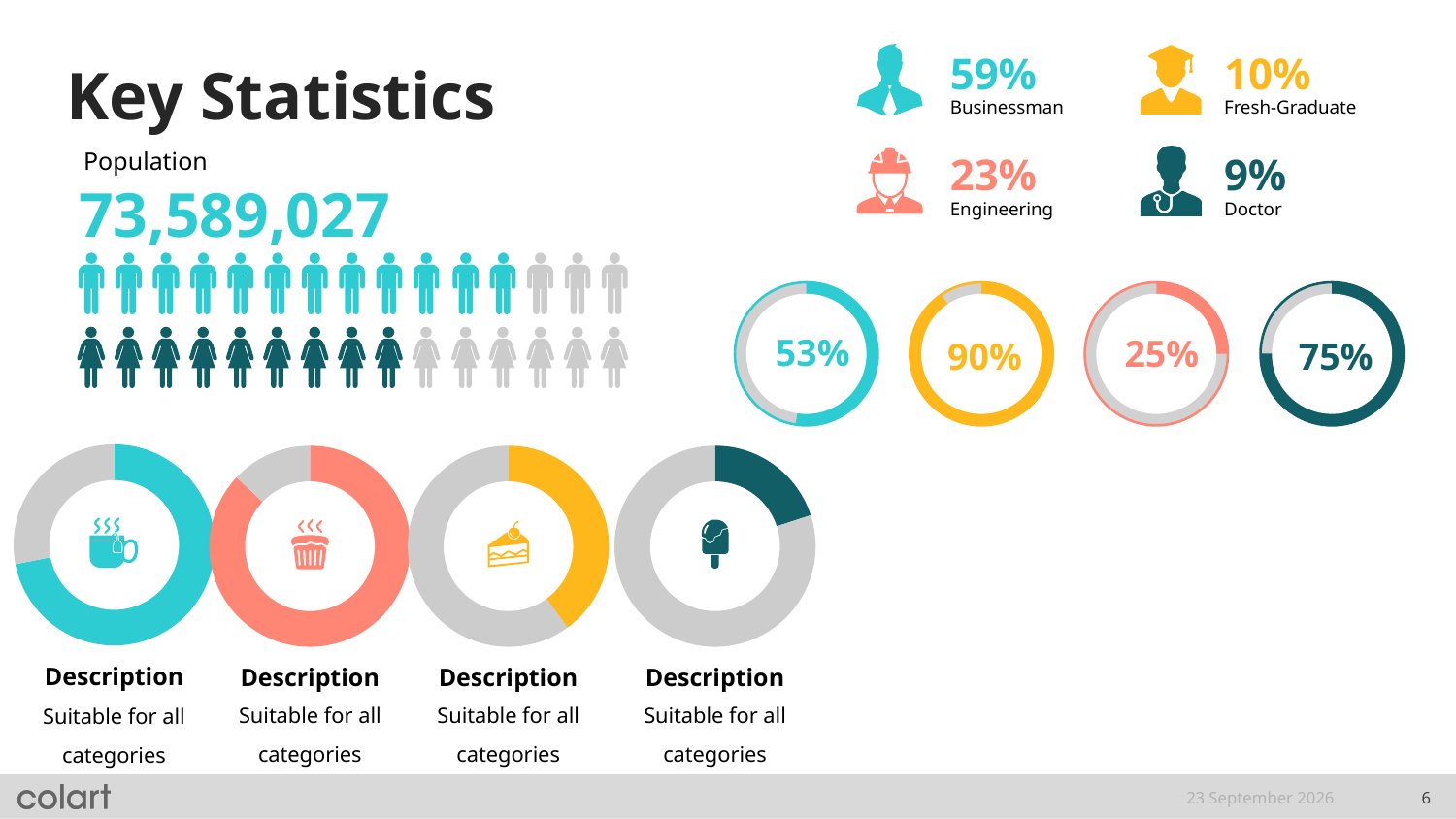
What is the difference between the Businessman percentage and the Engineering percentage in the icon statistics? 36% What percentage is shown for Businessman in the icon statistics at the top right? 59% What percentage is shown for Engineering in the icon statistics? 23% Of the four ring charts on the right (53%, 90%, 25%, 75%), which value is the highest? 90% What population figure is printed under the 'Population' label? 73,589,027 Which is larger in the icon statistics, the Fresh-Graduate percentage or the Doctor percentage? Fresh-Graduate What percentage is shown for Doctor in the icon statistics? 9% What value is shown in the salmon/pink ring chart in the row of four ring charts on the right? 25% How many ring charts are in the row on the right side of the slide? 4 Among the four icon statistics (Businessman, Fresh-Graduate, Engineering, Doctor), which category has the lowest percentage? Doctor What value is shown in the yellow ring chart in the row of four ring charts on the right? 90% Among the four icon statistics (Businessman, Fresh-Graduate, Engineering, Doctor), which category has the highest percentage? Businessman